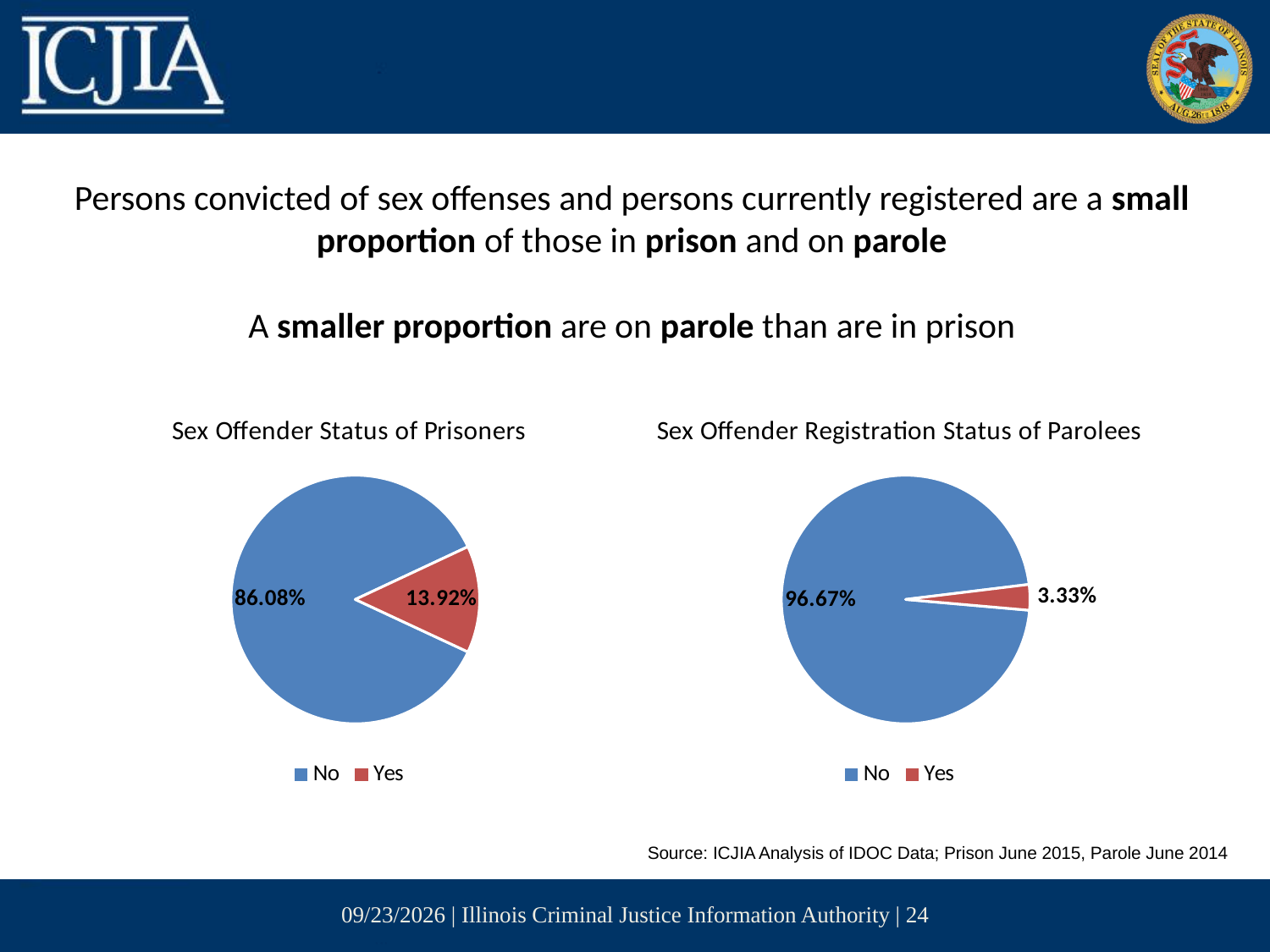
What type of chart is 'Sex Offender Status of Prisoners'? Pie chart What is the difference between the 'Yes' share in the 'Sex Offender Status of Prisoners' chart and the 'Yes' share in the 'Sex Offender Registration Status of Parolees' chart? 10.59% In the 'Sex Offender Registration Status of Parolees' chart, what percentage of parolees are labelled 'No'? 96.67% In the 'Sex Offender Registration Status of Parolees' chart, what percentage of parolees are labelled 'Yes'? 3.33% In the 'Sex Offender Status of Prisoners' chart, what percentage of prisoners are labelled 'No'? 86.08% In the 'Sex Offender Status of Prisoners' chart, what is the difference between the 'No' and 'Yes' shares? 72.16% In the 'Sex Offender Status of Prisoners' chart, what percentage of prisoners are labelled 'Yes'? 13.92% How many entries does the legend of the 'Sex Offender Status of Prisoners' chart list? 2 How many slices does the 'Sex Offender Registration Status of Parolees' chart have? 2 Which is larger: the 'Yes' share in the 'Sex Offender Status of Prisoners' chart or the 'Yes' share in the 'Sex Offender Registration Status of Parolees' chart? Sex Offender Status of Prisoners In the 'Sex Offender Registration Status of Parolees' chart, which category has the smallest slice? Yes In the 'Sex Offender Status of Prisoners' chart, which category has the largest slice? No